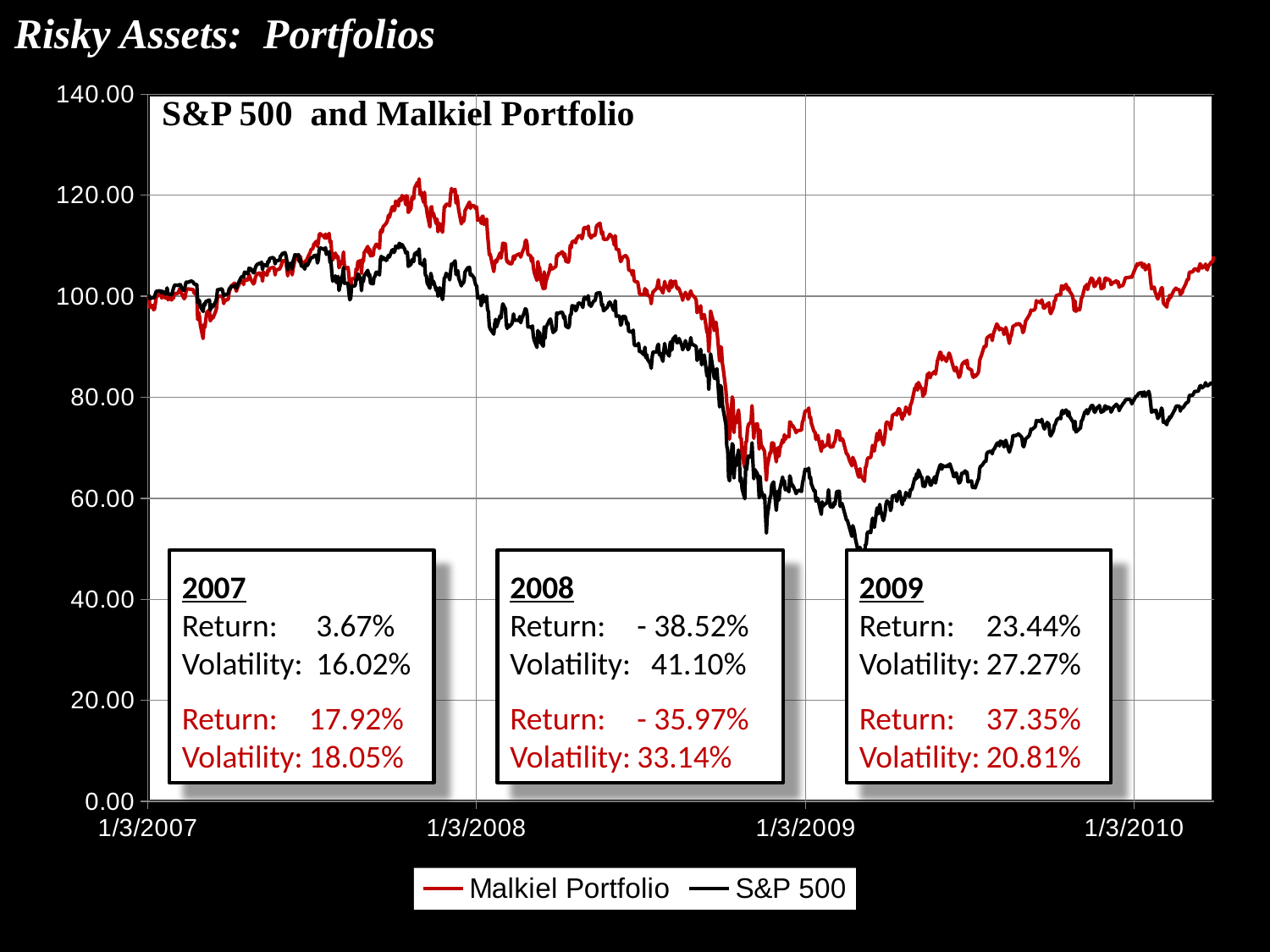
Is the lowest point of the S&P 500 line greater or less than 60? less In the 2009 box, what volatility is shown in red text? 20.81% What colour is the Malkiel Portfolio line? red Is the value of the Malkiel Portfolio line at 1/3/2010 greater or less than 100? greater How many series does the legend list? 2 At 1/3/2010, which series has the higher value, Malkiel Portfolio or S&P 500? Malkiel Portfolio What kind of chart is shown on the slide? line chart In the 2007 box, what return is shown in black text? 3.67% Between 1/3/2008 and 1/3/2009, does the S&P 500 line generally rise or fall? fall Between 1/3/2009 and 1/3/2010, does the Malkiel Portfolio line generally rise or fall? rise In the 2008 box, what return is shown in black text? - 38.52% What is the title of the chart? S&P 500 and Malkiel Portfolio